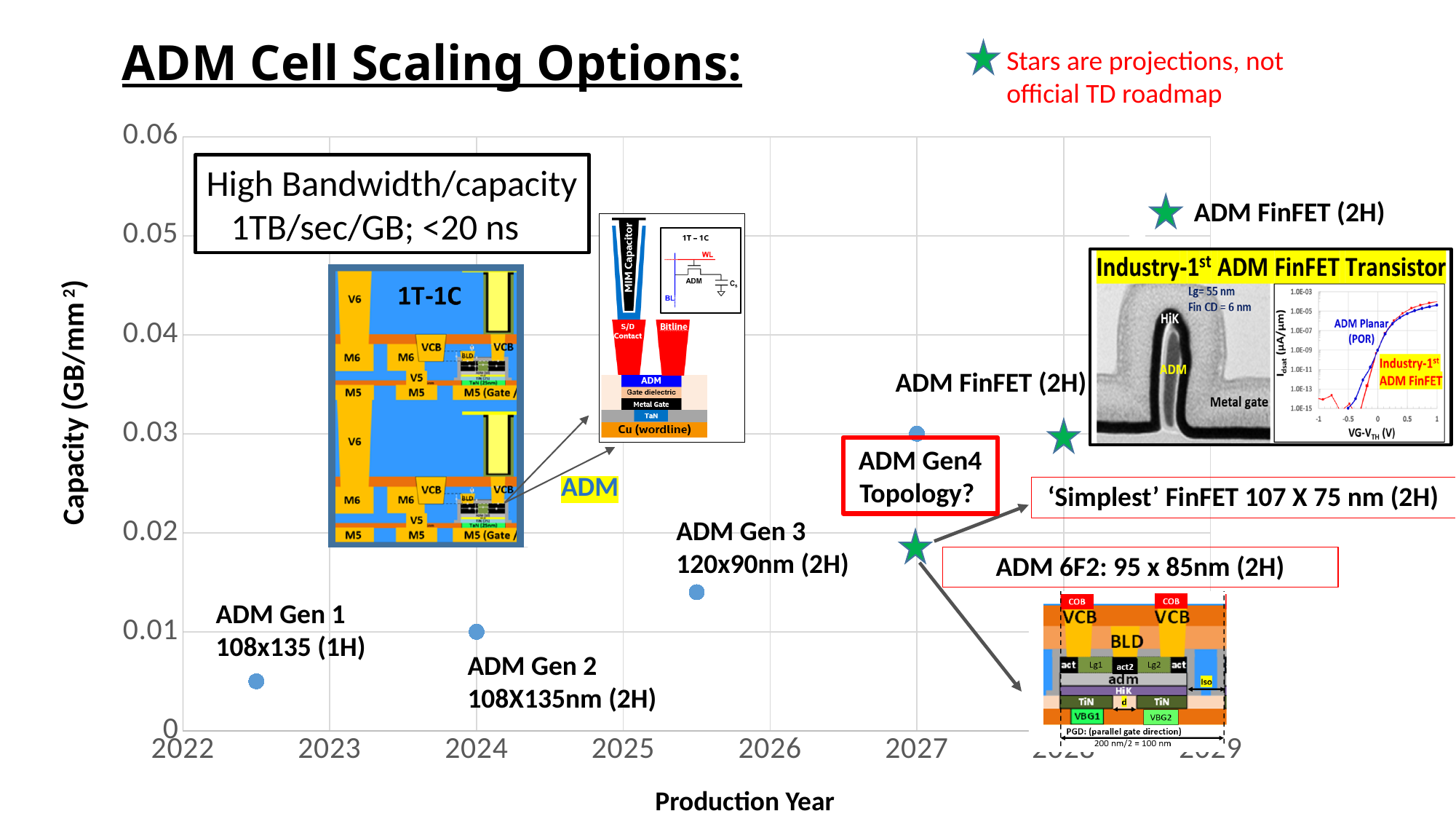
What is the title of the x axis of the chart? Production Year What capacity value is plotted for ADM Gen 2? 0.01 Is the capacity value for ADM Gen 3 greater or less than 0.01? greater Which labeled point has the lowest capacity on the chart? ADM Gen 1 Is the capacity value for ADM Gen 3 greater or less than 0.02? less Which has the higher plotted capacity, ADM Gen 2 or ADM Gen 3? ADM Gen 3 What is the first year shown on the x axis? 2022 Do the plotted capacity values rise or fall as the production year increases? rise According to the legend note, what do the stars on the chart represent? Projections, not official TD roadmap Is the capacity value for ADM Gen 1 greater or less than 0.01? less What is the maximum value shown on the y axis? 0.06 What kind of chart is shown on the slide? scatter chart